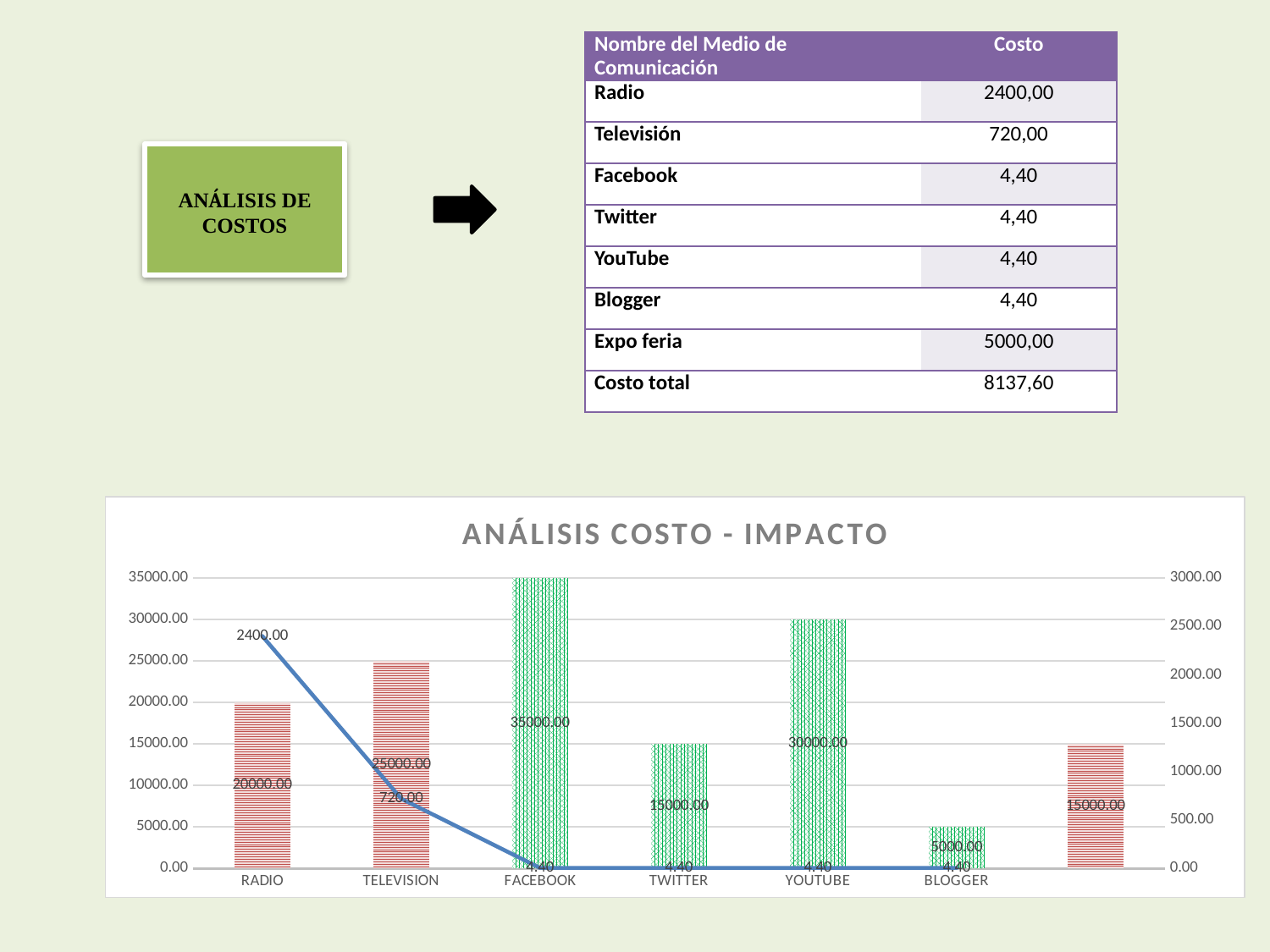
What is the bar value for RADIO in the chart? 20000.00 What is the bar value for YOUTUBE in the chart? 30000.00 What is the line value for RADIO in the chart? 2400.00 Does the line series rise or fall from RADIO to FACEBOOK? fall Which has a larger bar value, TELEVISION or YOUTUBE? YOUTUBE What is the line value for TELEVISION in the chart? 720.00 How many category labels are shown on the x axis of the chart? 6 What is the title of the chart on the slide? ANÁLISIS COSTO - IMPACTO Which labeled category has the highest bar in the chart? FACEBOOK Which labeled category has the lowest bar in the chart? BLOGGER What is the bar value for FACEBOOK in the chart? 35000.00 What is the difference between the bar values for FACEBOOK and TWITTER? 20000.00